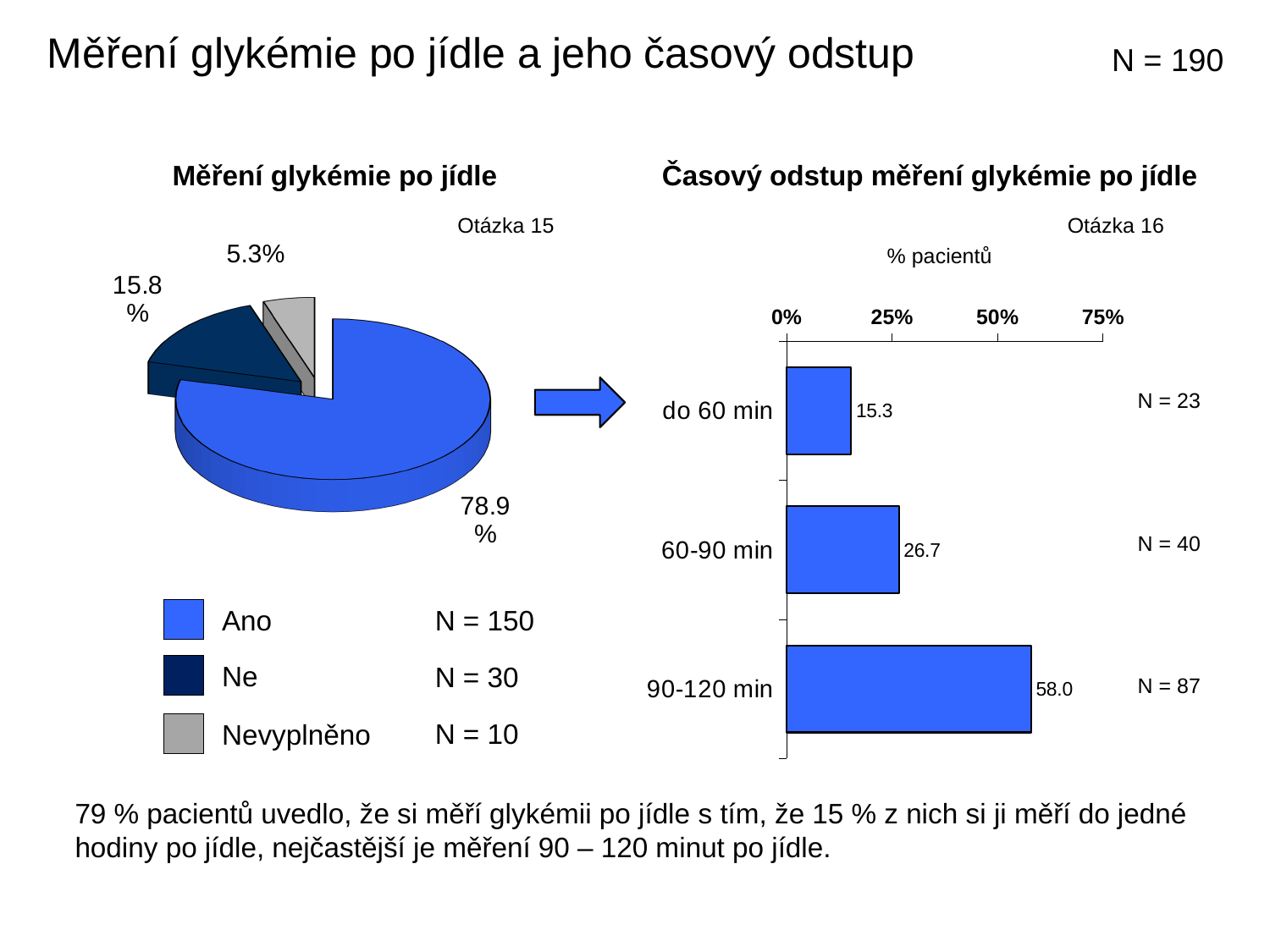
In the pie chart 'Měření glykémie po jídle', how many categories does the legend list? 3 In the bar chart 'Časový odstup měření glykémie po jídle', what is the difference between the values for '90-120 min' and '60-90 min'? 31.3 In the pie chart 'Měření glykémie po jídle', what share of patients answered 'Ano'? 78.9% In the bar chart 'Časový odstup měření glykémie po jídle', which category has the lowest value? do 60 min In the bar chart 'Časový odstup měření glykémie po jídle', what is the value for '60-90 min'? 26.7 What kind of chart is 'Časový odstup měření glykémie po jídle'? bar chart In the pie chart 'Měření glykémie po jídle', which category has the largest slice? Ano In the bar chart 'Časový odstup měření glykémie po jídle', is the value for '90-120 min' greater or less than 50%? greater In the pie chart 'Měření glykémie po jídle', which category has the smallest slice? Nevyplněno In the pie chart 'Měření glykémie po jídle', what share is labelled 'Nevyplněno'? 5.3% In the bar chart 'Časový odstup měření glykémie po jídle', what is the value for '90-120 min'? 58.0 In the pie chart 'Měření glykémie po jídle', what share of patients answered 'Ne'? 15.8%